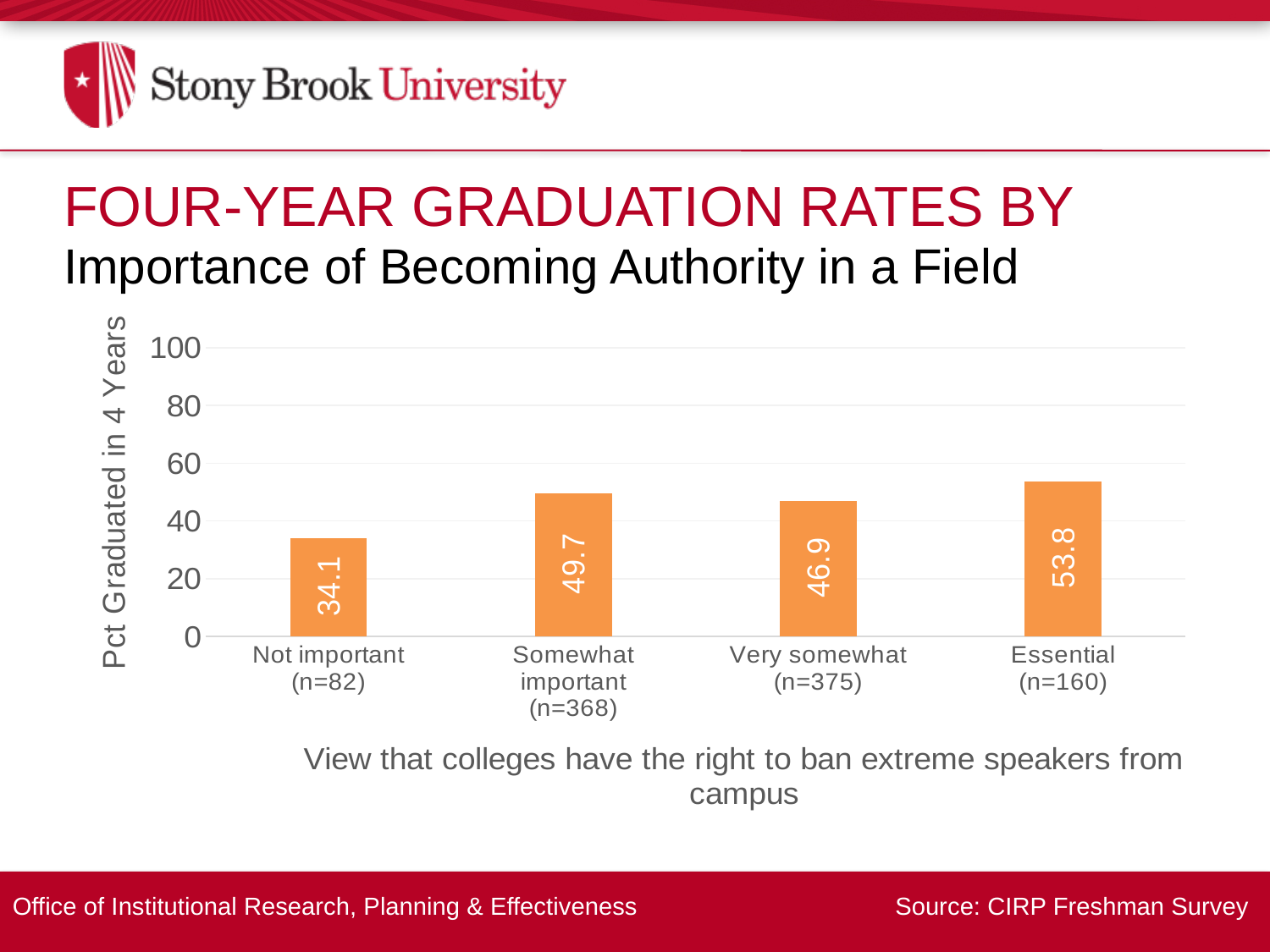
What is the four-year graduation rate for the 'Not important (n=82)' category? 34.1 What is the difference between the graduation rates for 'Essential' and 'Not important'? 19.7 Is the value for 'Not important' greater or less than 40? less What is the four-year graduation rate for the 'Somewhat important (n=368)' category? 49.7 How many categories are shown on the x axis? 4 Which category has the lowest four-year graduation rate? Not important (n=82) What is the four-year graduation rate for the 'Very somewhat (n=375)' category? 46.9 What kind of chart is shown on the slide? Bar chart What is the four-year graduation rate for the 'Essential (n=160)' category? 53.8 What is the label of the y axis? Pct Graduated in 4 Years Which category has the highest four-year graduation rate? Essential (n=160) Which has a higher graduation rate, 'Somewhat important' or 'Very somewhat'? Somewhat important